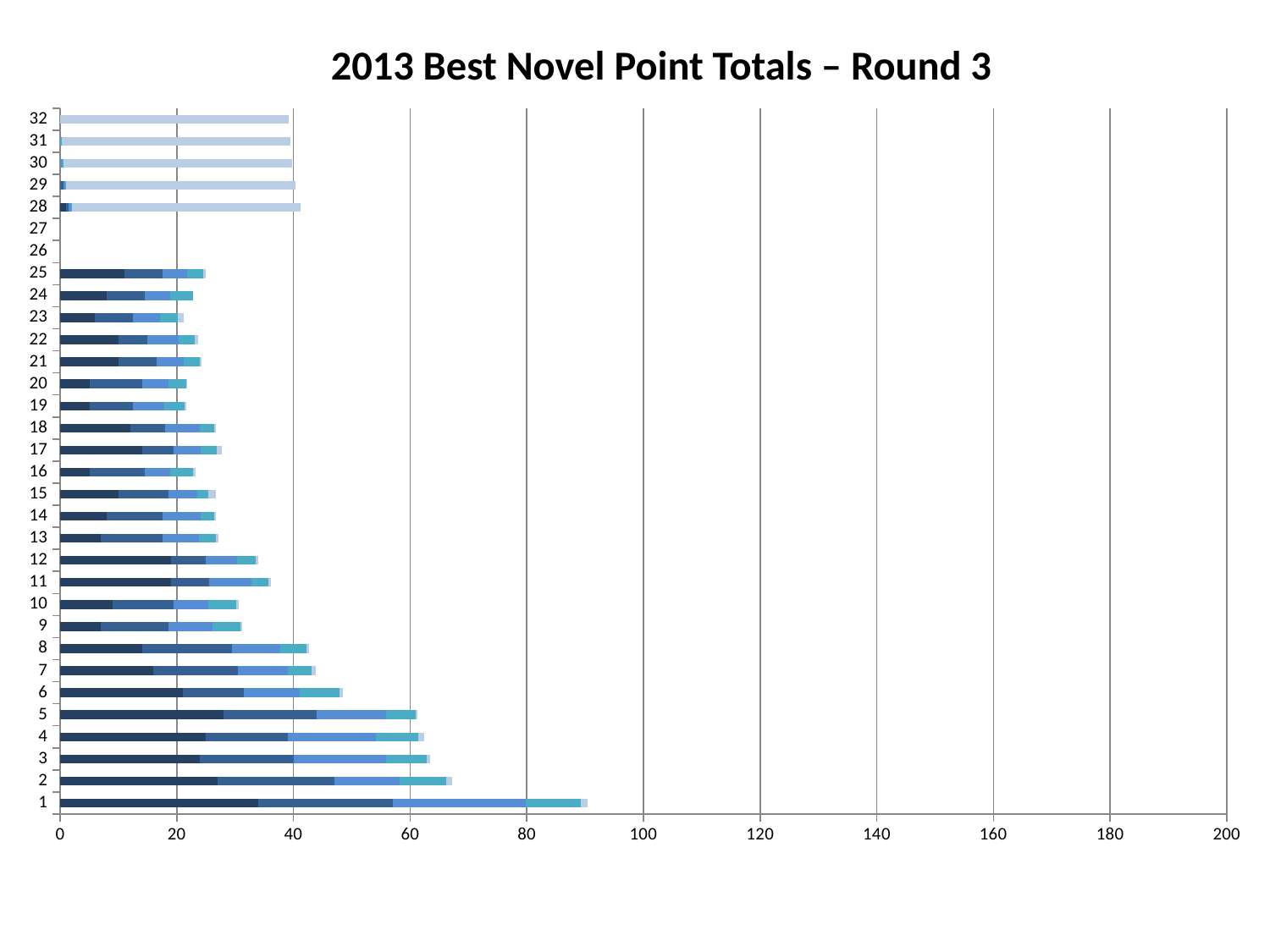
What is the title of the chart? 2013 Best Novel Point Totals – Round 3 How many categories are listed on the vertical axis of the chart? 32 Which has the larger total, category 8 or category 9? 8 Is the total value for category 2 greater or less than 60? greater Is the total value for category 6 greater or less than 40? greater What is the maximum value shown on the horizontal axis? 200 Which has the larger total, category 1 or category 2? 1 Which category has the longest bar in the chart? 1 What kind of chart is shown on the slide? bar chart Is the total value for category 12 greater or less than 40? less